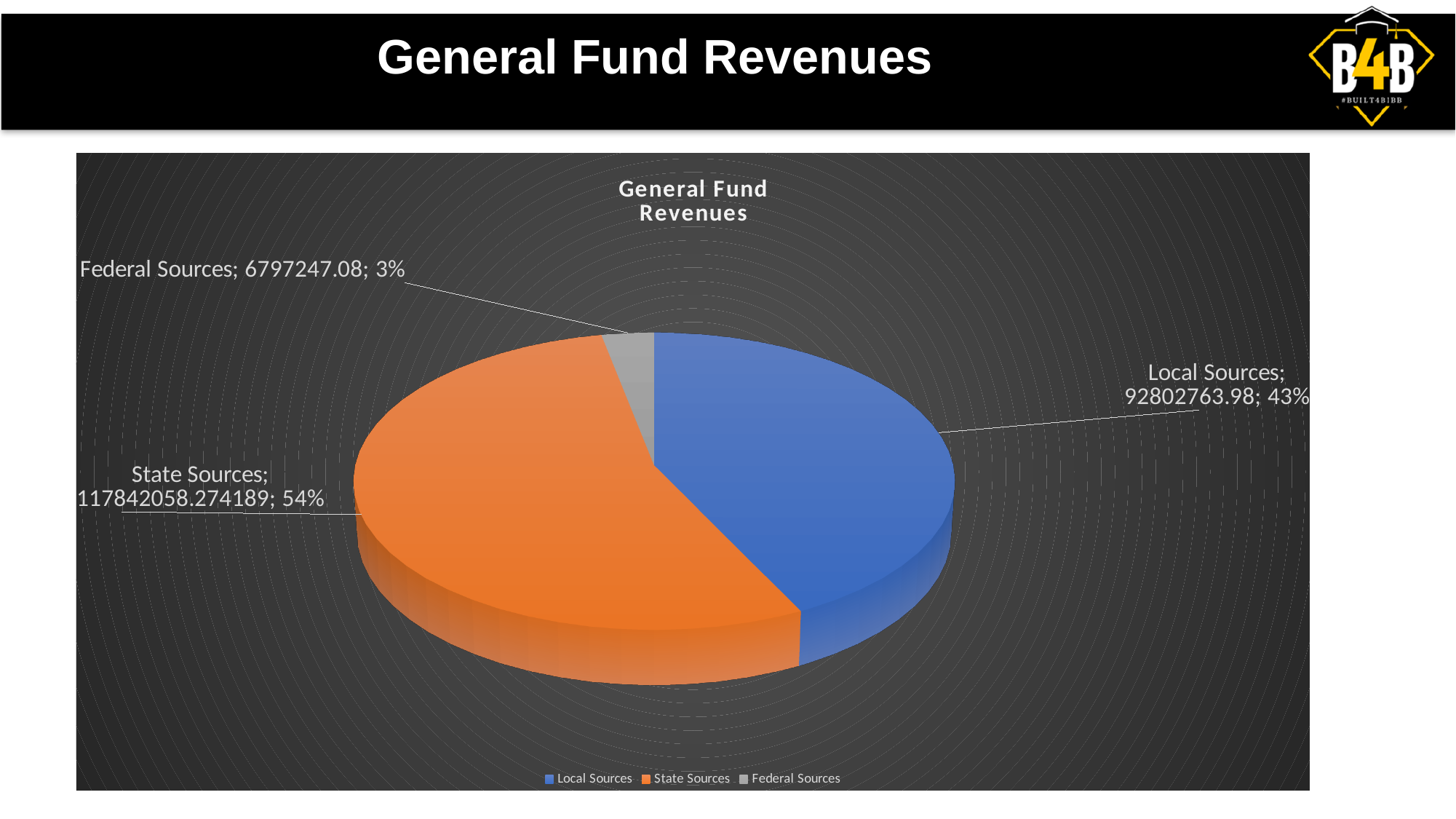
What is the value for State Sources? 117842058.274189 Which source has the largest slice of the pie? State Sources What share of the pie does Local Sources represent? 43% What share of the pie does State Sources represent? 54% What share of the pie does Federal Sources represent? 3% What is the value for Local Sources? 92802763.98 What is the value for Federal Sources? 6797247.08 Which is larger, Local Sources or State Sources? State Sources Which source has the smallest slice of the pie? Federal Sources How many categories does the pie chart show? 3 What colour is the State Sources slice? Orange What kind of chart is shown on the slide? Pie chart